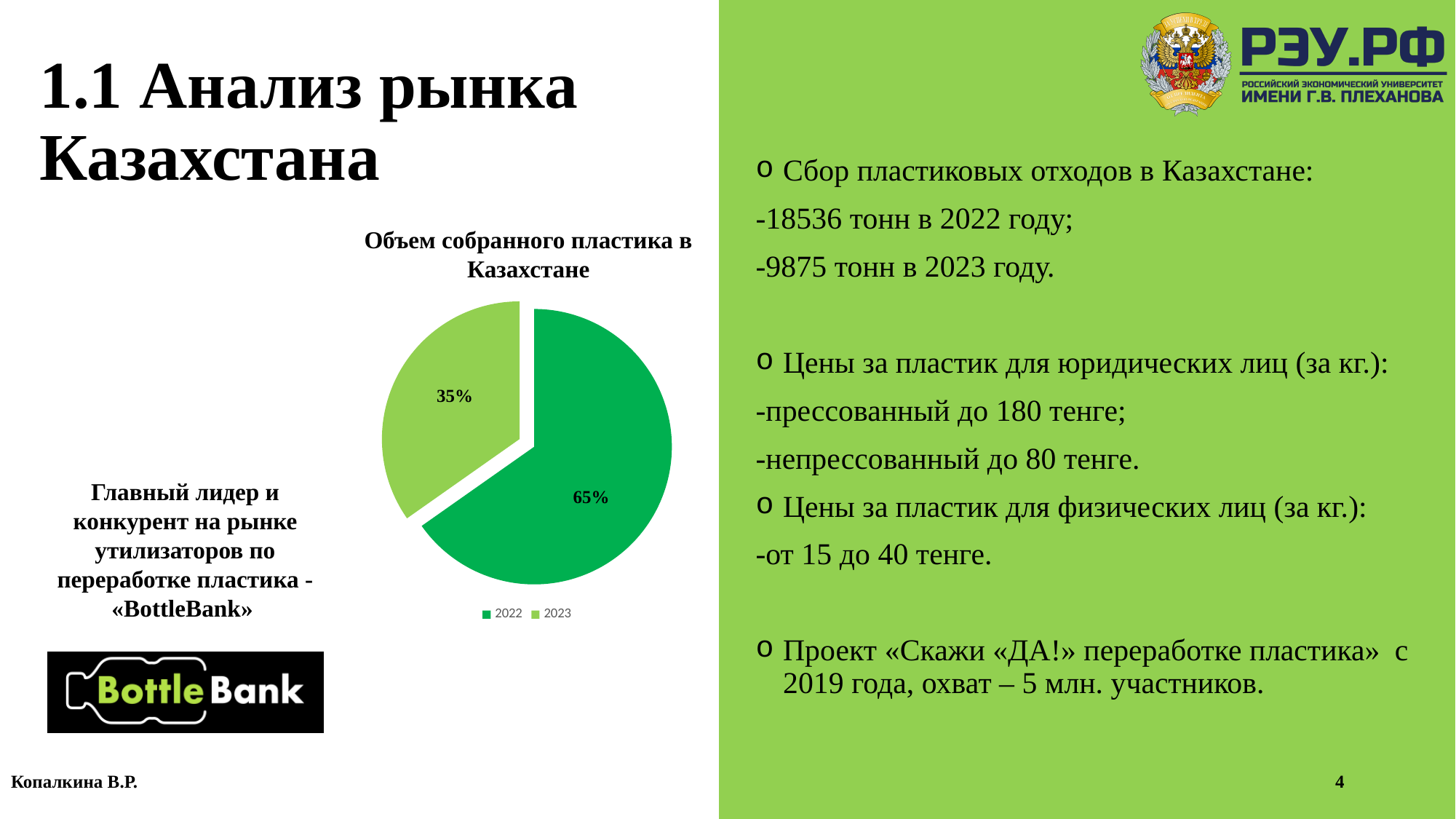
What type of chart is shown on the slide? pie chart What is the difference in percentage points between the 2022 and 2023 slices? 30 Which legend entry is shown in the lighter green colour? 2023 Which year has the largest slice of the pie? 2022 What share of the pie does 2022 represent? 65% What share of the pie does 2023 represent? 35% How many entries does the legend list? 2 What is the title of the chart? Объем собранного пластика в Казахстане Which slice is larger, 2022 or 2023? 2022 How many slices does the pie chart have? 2 Which year has the smallest slice of the pie? 2023